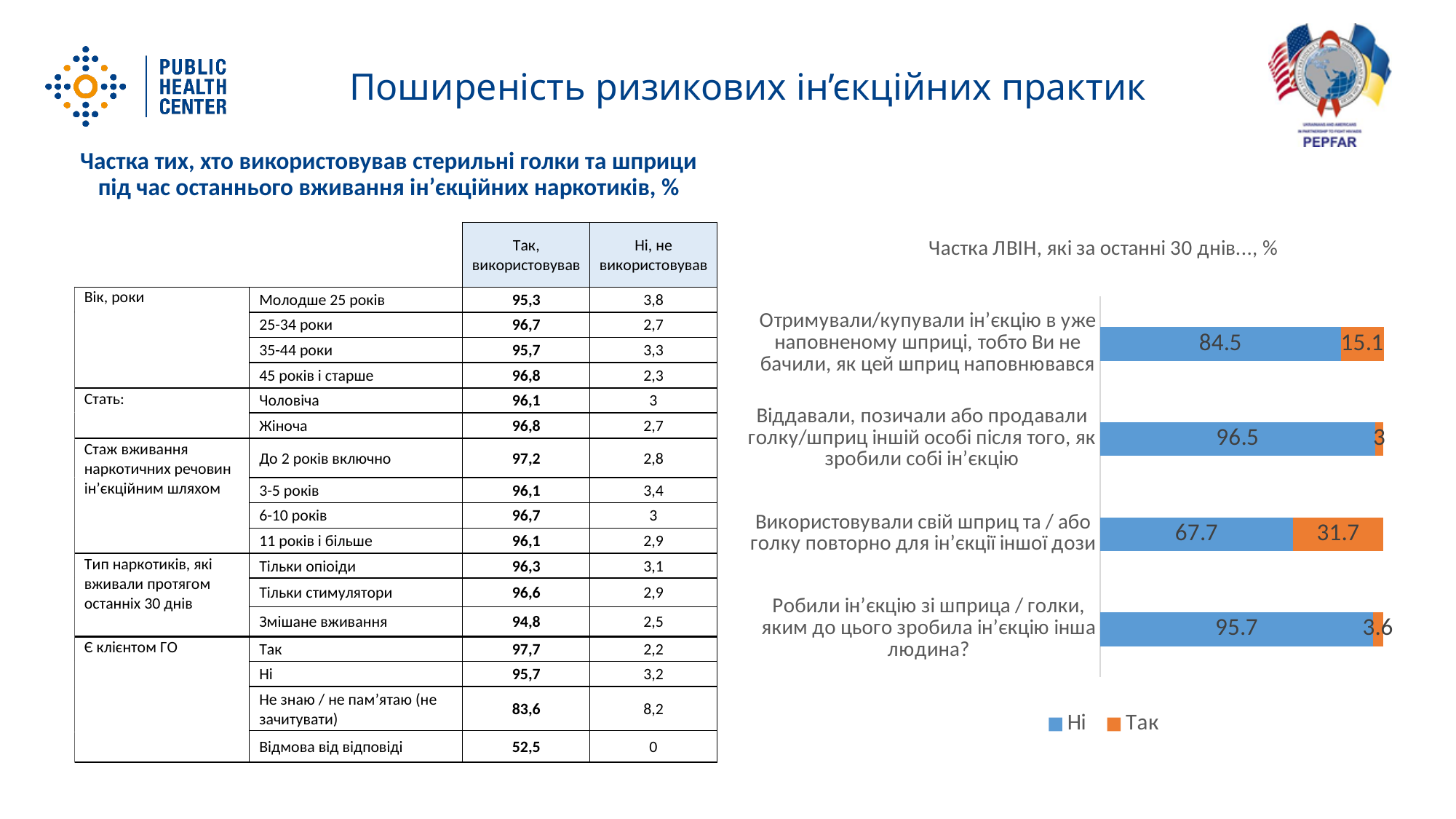
In the chart 'Частка ЛВІН, які за останні 30 днів…, %', what is the 'Ні' value for 'Отримували/купували ін’єкцію в уже наповненому шприці'? 84.5 How many series does the legend of the chart 'Частка ЛВІН, які за останні 30 днів…, %' list? 2 In the chart 'Частка ЛВІН, які за останні 30 днів…, %', what is the 'Ні' value for 'Віддавали, позичали або продавали голку/шприц іншій особі'? 96.5 In the chart 'Частка ЛВІН, які за останні 30 днів…, %', which practice has the highest 'Так' value? Використовували свій шприц та / або голку повторно для ін’єкції іншої дози How many practices (categories) are shown in the chart 'Частка ЛВІН, які за останні 30 днів…, %'? 4 In the chart 'Частка ЛВІН, які за останні 30 днів…, %', what is the 'Ні' value for 'Робили ін’єкцію зі шприца / голки, яким до цього зробила ін’єкцію інша людина?'? 95.7 What type of chart is 'Частка ЛВІН, які за останні 30 днів…, %'? Stacked horizontal bar chart In the chart 'Частка ЛВІН, які за останні 30 днів…, %', what is the 'Так' value for 'Використовували свій шприц та / або голку повторно для ін’єкції іншої дози'? 31.7 In the chart 'Частка ЛВІН, які за останні 30 днів…, %', what is the 'Так' value for 'Отримували/купували ін’єкцію в уже наповненому шприці'? 15.1 In the chart 'Частка ЛВІН, які за останні 30 днів…, %', which practice has the lowest 'Ні' value? Використовували свій шприц та / або голку повторно для ін’єкції іншої дози In the chart 'Частка ЛВІН, які за останні 30 днів…, %', what is the difference between the 'Ні' values for 'Отримували/купували ін’єкцію в уже наповненому шприці' (84.5) and 'Використовували свій шприц та / або голку повторно' (67.7)? 16.8 In the chart 'Частка ЛВІН, які за останні 30 днів…, %', which is larger: the 'Так' value for 'Використовували свій шприц та / або голку повторно' or the 'Так' value for 'Отримували/купували ін’єкцію в уже наповненому шприці'? Використовували свій шприц та / або голку повторно (31.7)